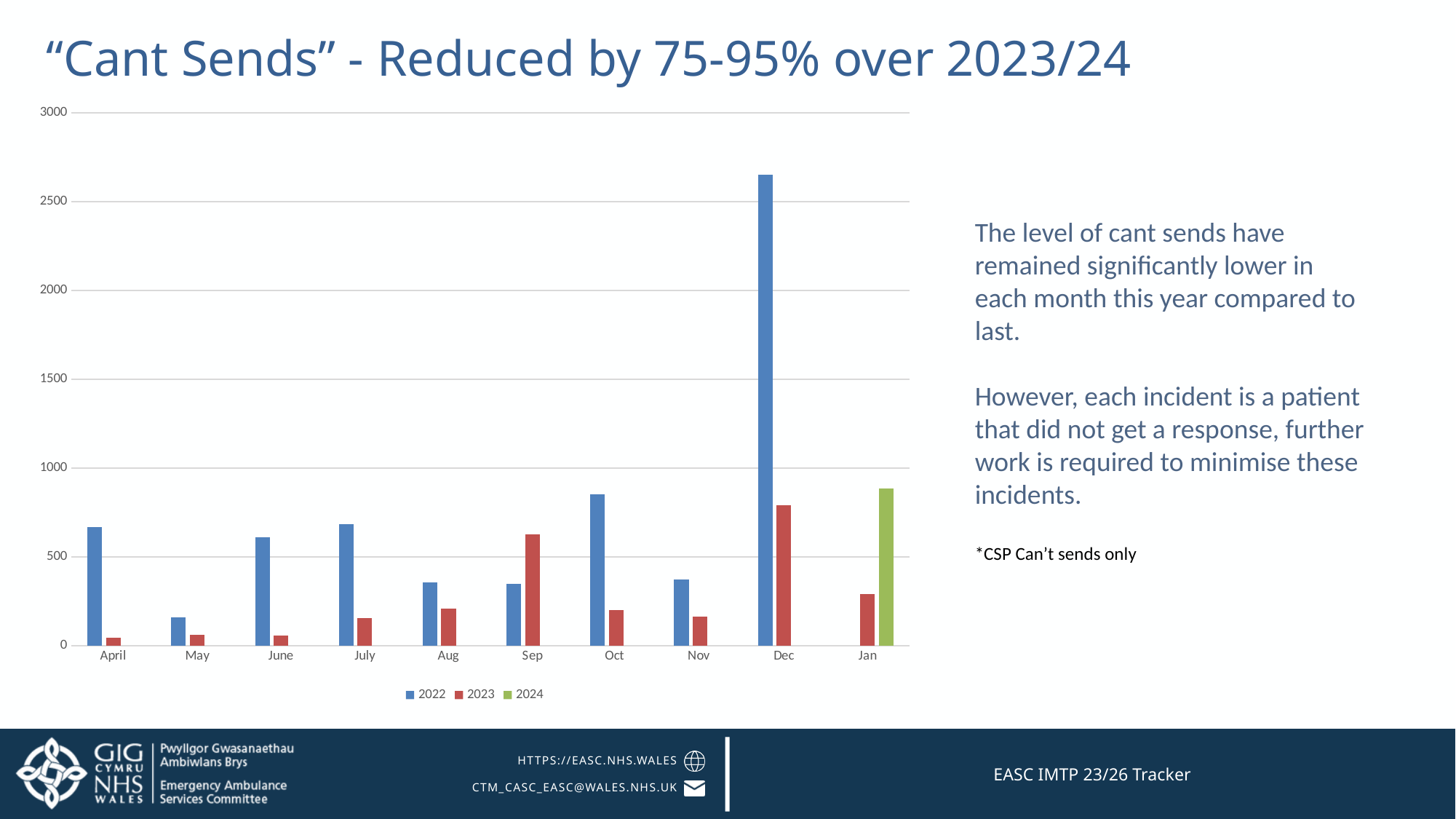
What kind of chart is shown on the slide? bar chart Which month is the only one with a bar for the 2024 series? Jan Is the value for 2022 in Oct greater or less than 1000? less Is the value for 2022 in Dec greater or less than 2500? greater In Sep, which series has the larger value, 2022 or 2023? 2023 Which month has the highest value for the 2023 series? Dec In April, which series has the larger value, 2022 or 2023? 2022 Which month has the lowest value for the 2022 series? May How many series does the legend list? 3 Is the value for 2023 in Dec greater or less than 500? greater How many months are shown on the x axis? 10 Which month has the highest value for the 2022 series? Dec